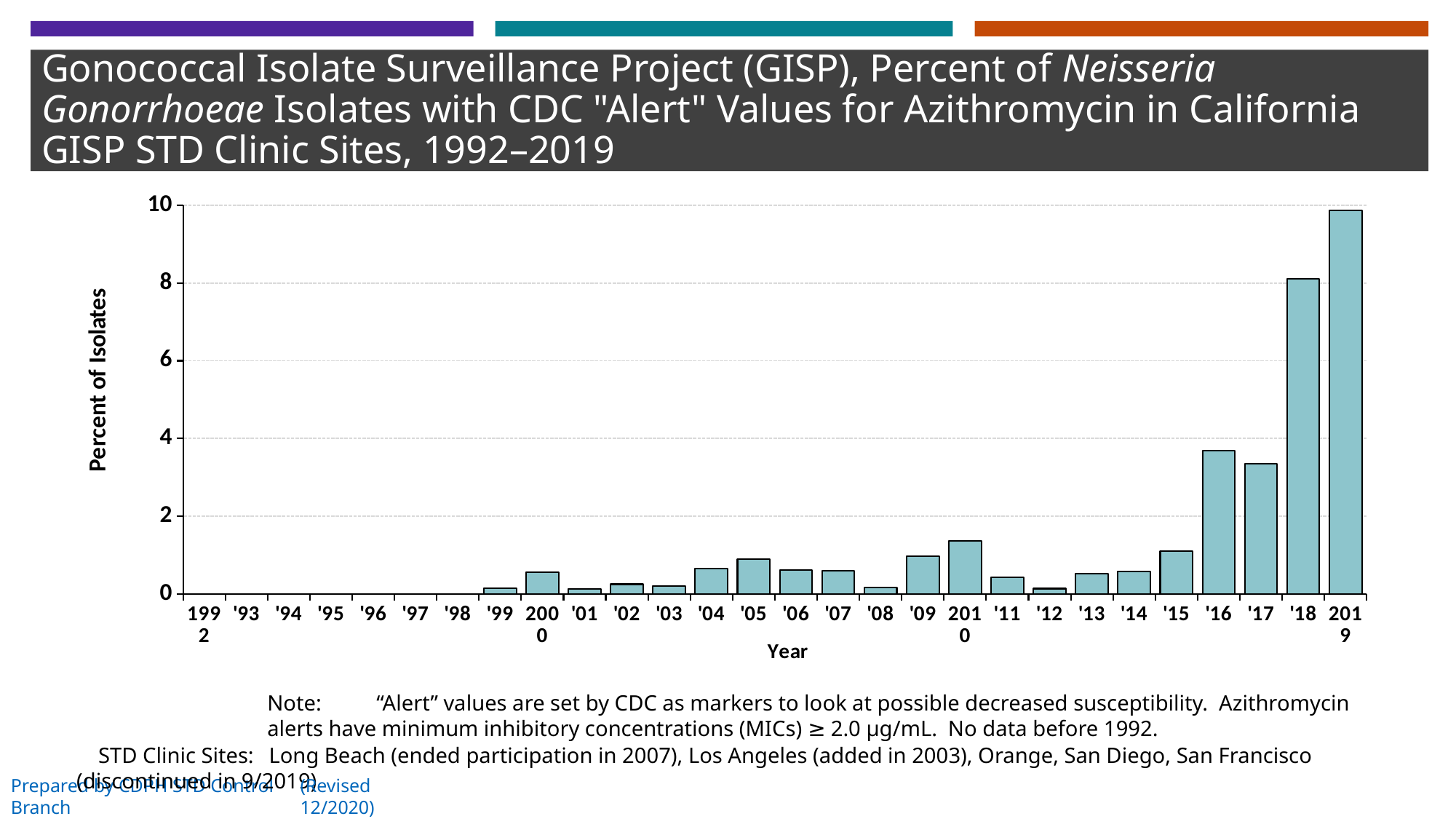
Is the value for 2018 greater or less than 6? greater Is the value for 2016 greater or less than 4? less Is the value for 2017 greater or less than 2? greater Which year has the larger value, 2015 or 2016? 2016 How many years are shown on the x axis? 28 Which year has the larger value, 2010 or 2011? 2010 Which year has the larger value, 2018 or 2019? 2019 What kind of chart is shown on the slide? bar chart What is the label of the y axis? Percent of Isolates Which year has the highest percent of isolates with azithromycin alert values? 2019